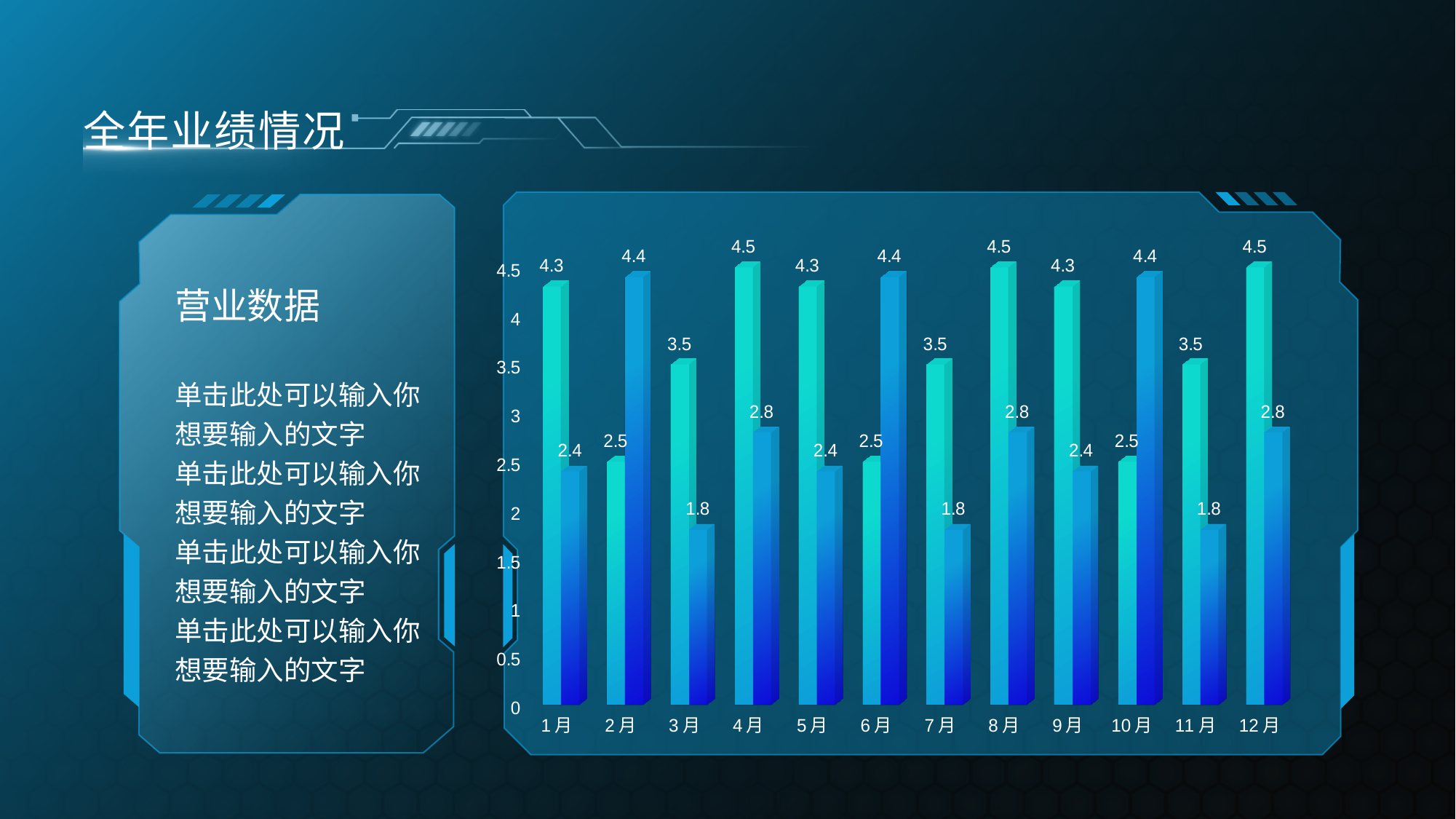
What is the highest value labelled on the chart? 4.5 What is the value of the green bar for 12月? 4.5 How many months (categories) are shown on the x axis of the chart? 12 What is the difference between the green bar and the blue bar for 4月? 1.7 What is the value of the green bar for 1月? 4.3 What is the lowest value labelled on the chart? 1.8 Which is larger for 7月, the green bar or the blue bar? the green bar What is the value of the blue bar for 6月? 4.4 What type of chart is shown on the slide? bar chart What is the difference between the green bar and the blue bar for 2月? 1.9 What is the value of the blue bar for 3月? 1.8 Which is larger for 10月, the green bar or the blue bar? the blue bar